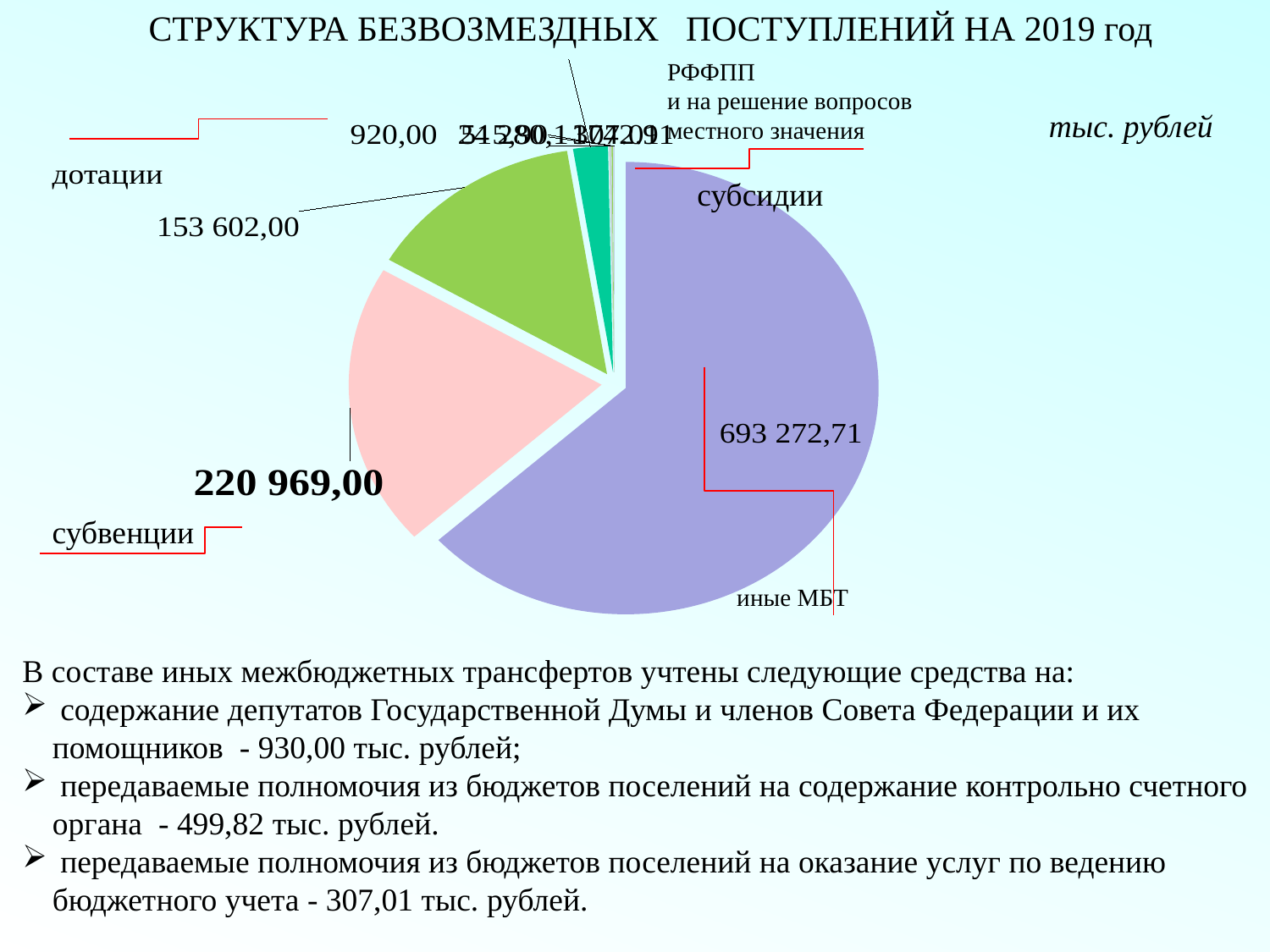
In what units are the values on the chart given? тыс. рублей What is the difference between субвенции and дотации? 67 367,00 What kind of chart is shown on the slide? pie chart What is the difference between субсидии and субвенции? 472 303,71 Is the value for дотации greater or less than 200 000? less Which is larger, субвенции or дотации? субвенции What is the title of the chart? СТРУКТУРА БЕЗВОЗМЕЗДНЫХ ПОСТУПЛЕНИЙ НА 2019 год Which category has the largest slice of the pie? субсидии What is the value for субсидии? 693 272,71 What is the value for дотации? 153 602,00 What is the value for субвенции? 220 969,00